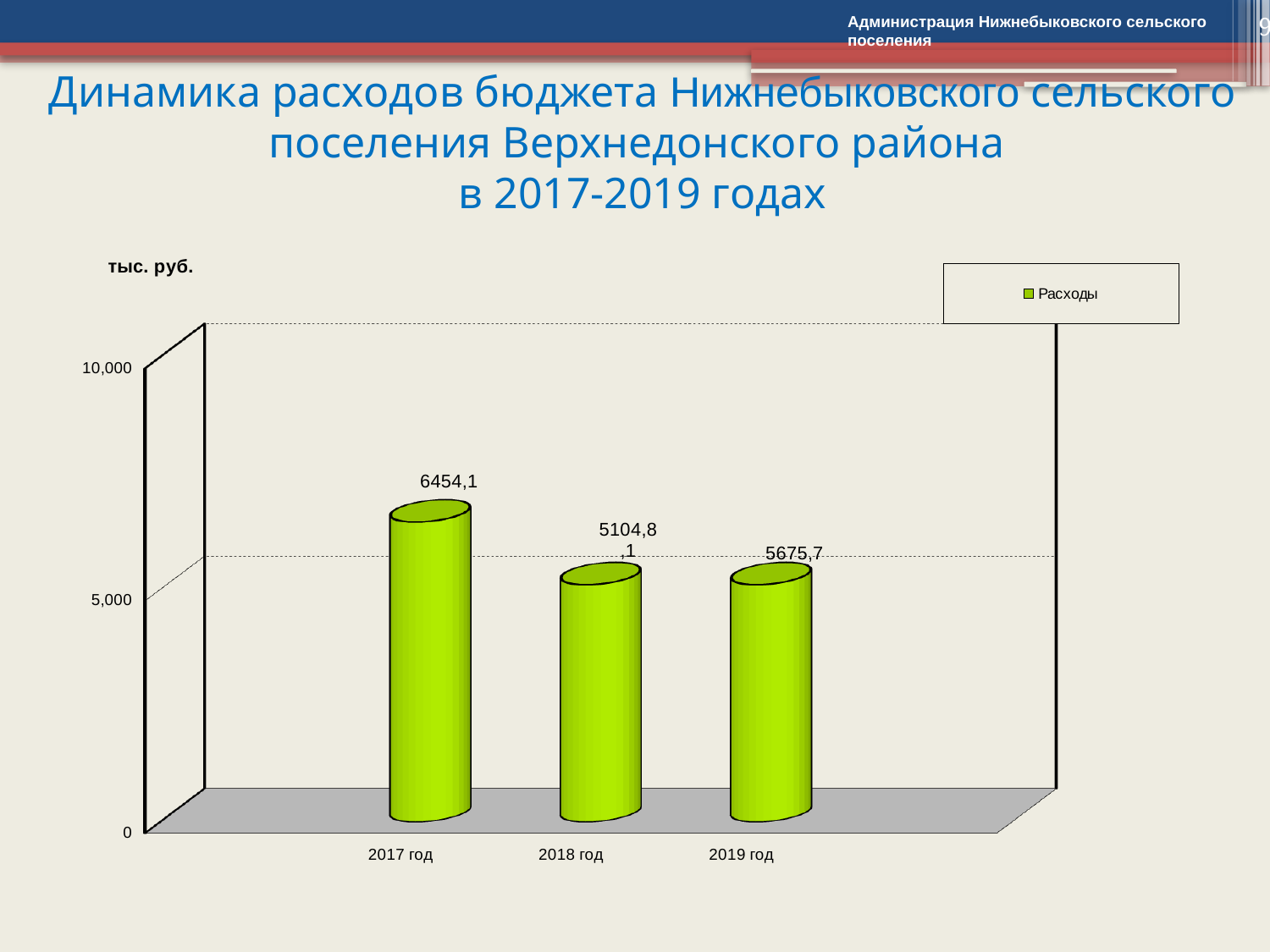
What is the value for 2019 год? 5675,7 Is the value for 2018 год greater or less than 10,000? less Is the value for 2017 год greater or less than 5,000? greater What is the difference between the values for 2017 год and 2019 год? 778,4 Which year has the lowest value? 2018 год What kind of chart is shown on the slide? bar chart How many years are shown on the chart? 3 What is the value for 2017 год? 6454,1 Which year has the highest value? 2017 год What series name is shown in the legend? Расходы How many series does the legend list? 1 Which is larger, the value for 2018 год or the value for 2019 год? 2019 год